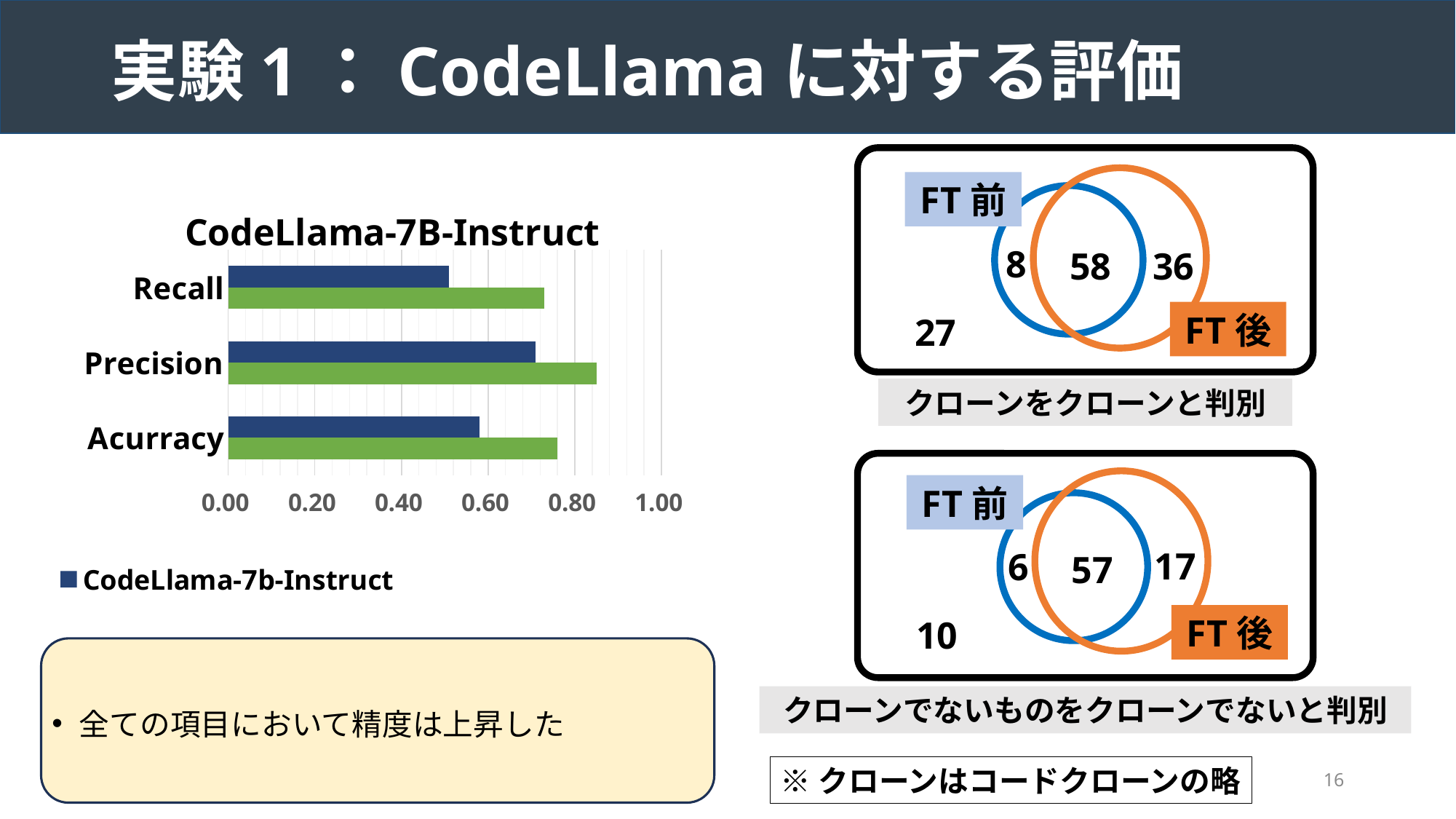
In the "CodeLlama-7B-Instruct" bar chart, which category has the longest green bar? Precision In the "CodeLlama-7B-Instruct" bar chart, which bar for Precision is longer, the blue one or the green one? the green one In the "CodeLlama-7B-Instruct" bar chart, is the blue (CodeLlama-7b-Instruct) bar for Recall greater or less than 0.60? less In the "CodeLlama-7B-Instruct" bar chart, is the blue (CodeLlama-7b-Instruct) bar for Precision greater or less than 0.60? greater In the upper Venn diagram on the right of the slide, what number is shown in the overlap of the FT 前 and FT 後 circles? 58 In the "CodeLlama-7B-Instruct" bar chart, which category has the shortest blue (CodeLlama-7b-Instruct) bar? Recall What kind of chart is the chart titled "CodeLlama-7B-Instruct"? bar chart In the "CodeLlama-7B-Instruct" bar chart, which category has the longest blue (CodeLlama-7b-Instruct) bar? Precision In the "CodeLlama-7B-Instruct" bar chart, is the green bar for Precision greater or less than 0.80? greater How many categories are shown on the y axis of the "CodeLlama-7B-Instruct" bar chart? 3 What is the title of the bar chart on the left of the slide? CodeLlama-7B-Instruct How many series does the legend of the "CodeLlama-7B-Instruct" bar chart list? 1